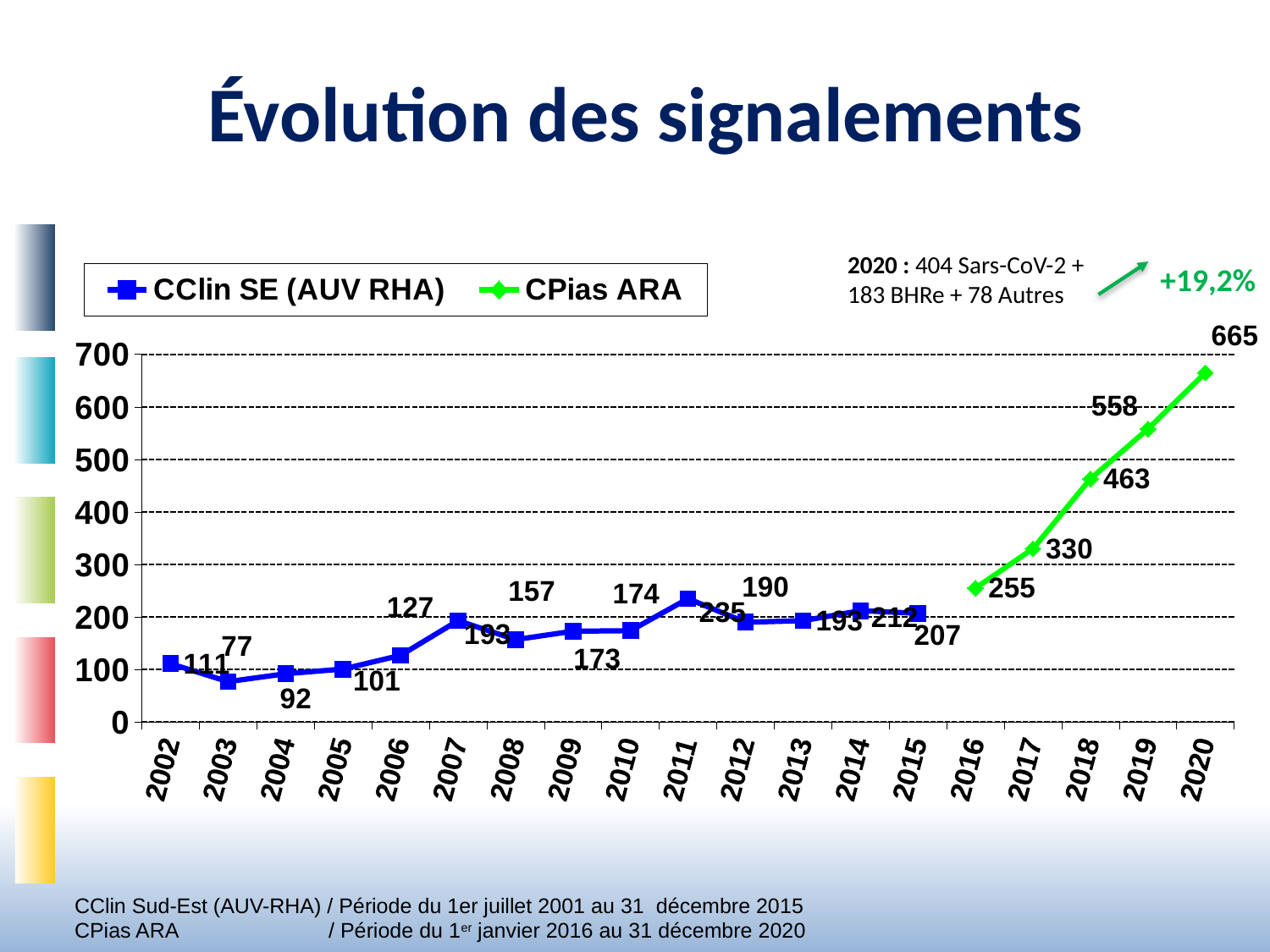
What type of chart is shown on the slide? line chart Do the CPias ARA values rise or fall from 2016 to 2020? rise Which is larger, the value for 2007 or the value for 2008? 2007 What is the difference between the CPias ARA values for 2020 and 2019? 107 What is the title of the chart? Évolution des signalements Which year has the highest value on the chart? 2020 How many series does the legend list? 2 Which year has the lowest value on the chart? 2003 What is the value for CPias ARA in 2018? 463 What is the value for CClin SE (AUV RHA) in 2011? 235 What is the value for CPias ARA in 2020? 665 What is the value for CClin SE (AUV RHA) in 2003? 77